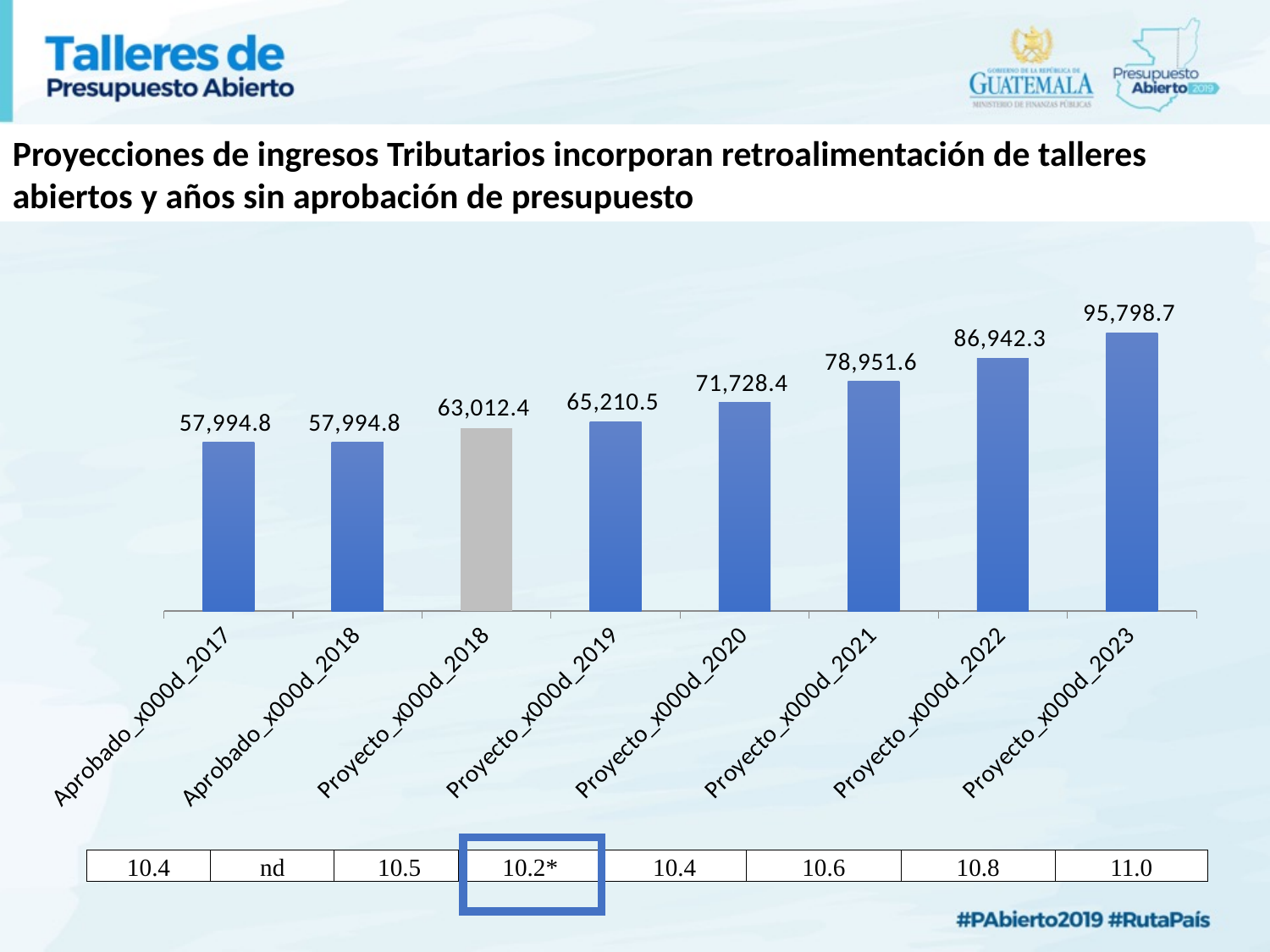
What is the value for Aprobado_x000d_2017? 57,994.8 What is the lowest value shown on the chart? 57,994.8 What is the difference between the values for Proyecto_x000d_2022 and Proyecto_x000d_2021? 7,990.7 What type of chart is shown on the slide? bar chart What is the value for Proyecto_x000d_2018? 63,012.4 Which category has the highest value? Proyecto_x000d_2023 What is the difference between the values for Proyecto_x000d_2023 and Aprobado_x000d_2017? 37,803.9 What is the value for Proyecto_x000d_2021? 78,951.6 Which is larger, the value for Proyecto_x000d_2019 or Proyecto_x000d_2020? Proyecto_x000d_2020 Do the values rise or fall from Proyecto_x000d_2018 to Proyecto_x000d_2023? rise How many bars (categories) does the chart show? 8 What is the value for Proyecto_x000d_2023? 95,798.7